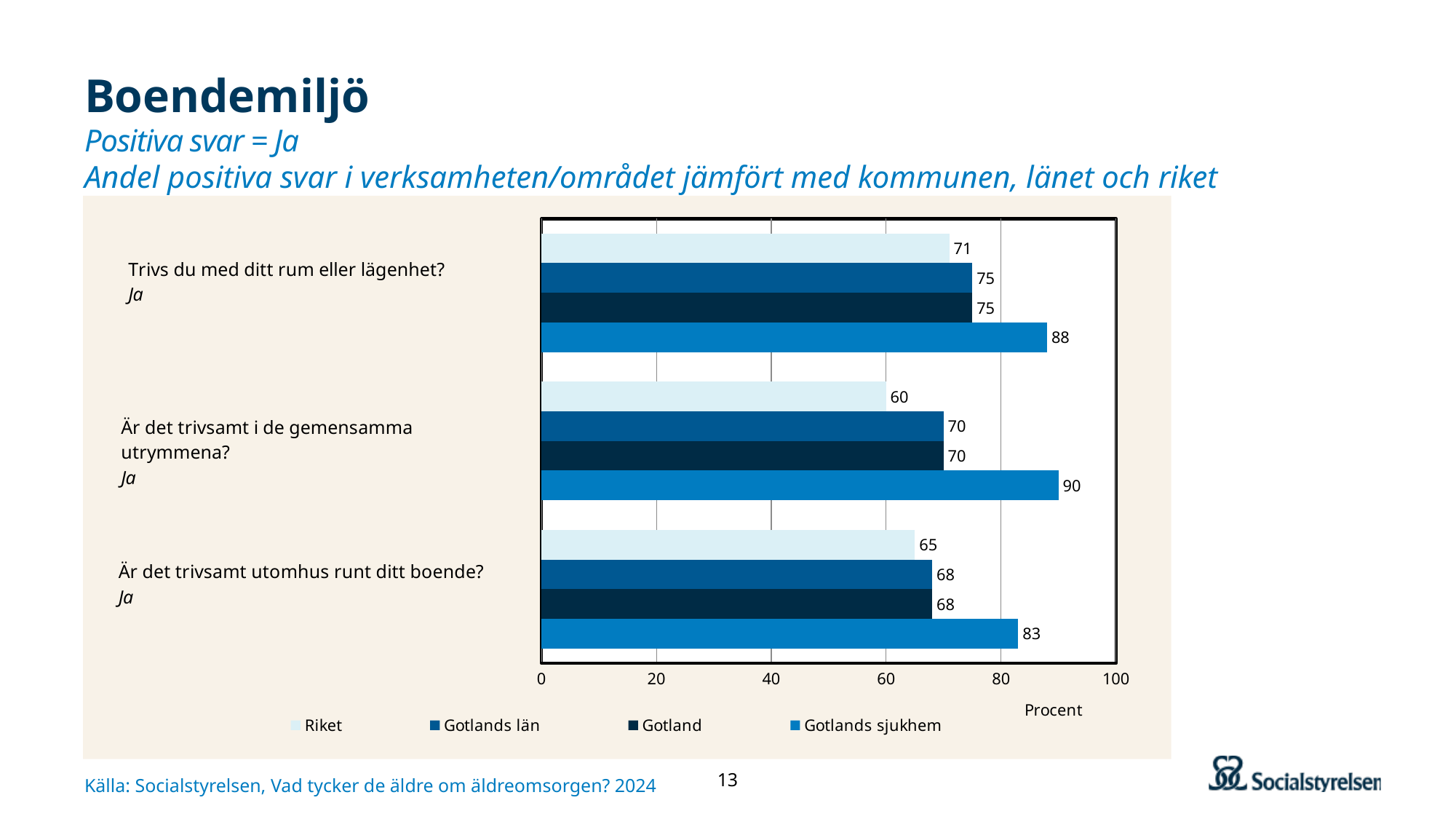
How many questions (categories) are shown in the chart? 3 What is the value for Gotlands sjukhem for "Trivs du med ditt rum eller lägenhet?"? 88 What is the difference between Gotlands sjukhem and Gotlands län for "Trivs du med ditt rum eller lägenhet?"? 13 How many series does the legend list? 4 What is the value for Riket for "Är det trivsamt i de gemensamma utrymmena?"? 60 Which is larger for Riket: the value for "Trivs du med ditt rum eller lägenhet?" or for "Är det trivsamt utomhus runt ditt boende?"? Trivs du med ditt rum eller lägenhet? What kind of chart is shown on the slide? Bar chart What is the difference between Gotlands sjukhem and Riket for "Är det trivsamt i de gemensamma utrymmena?"? 30 Which series has the highest value for "Är det trivsamt i de gemensamma utrymmena?"? Gotlands sjukhem Which series has the lowest value for "Är det trivsamt utomhus runt ditt boende?"? Riket Is the value for Gotlands sjukhem for "Är det trivsamt utomhus runt ditt boende?" greater or less than 80? greater What is the value for Gotland for "Är det trivsamt utomhus runt ditt boende?"? 68